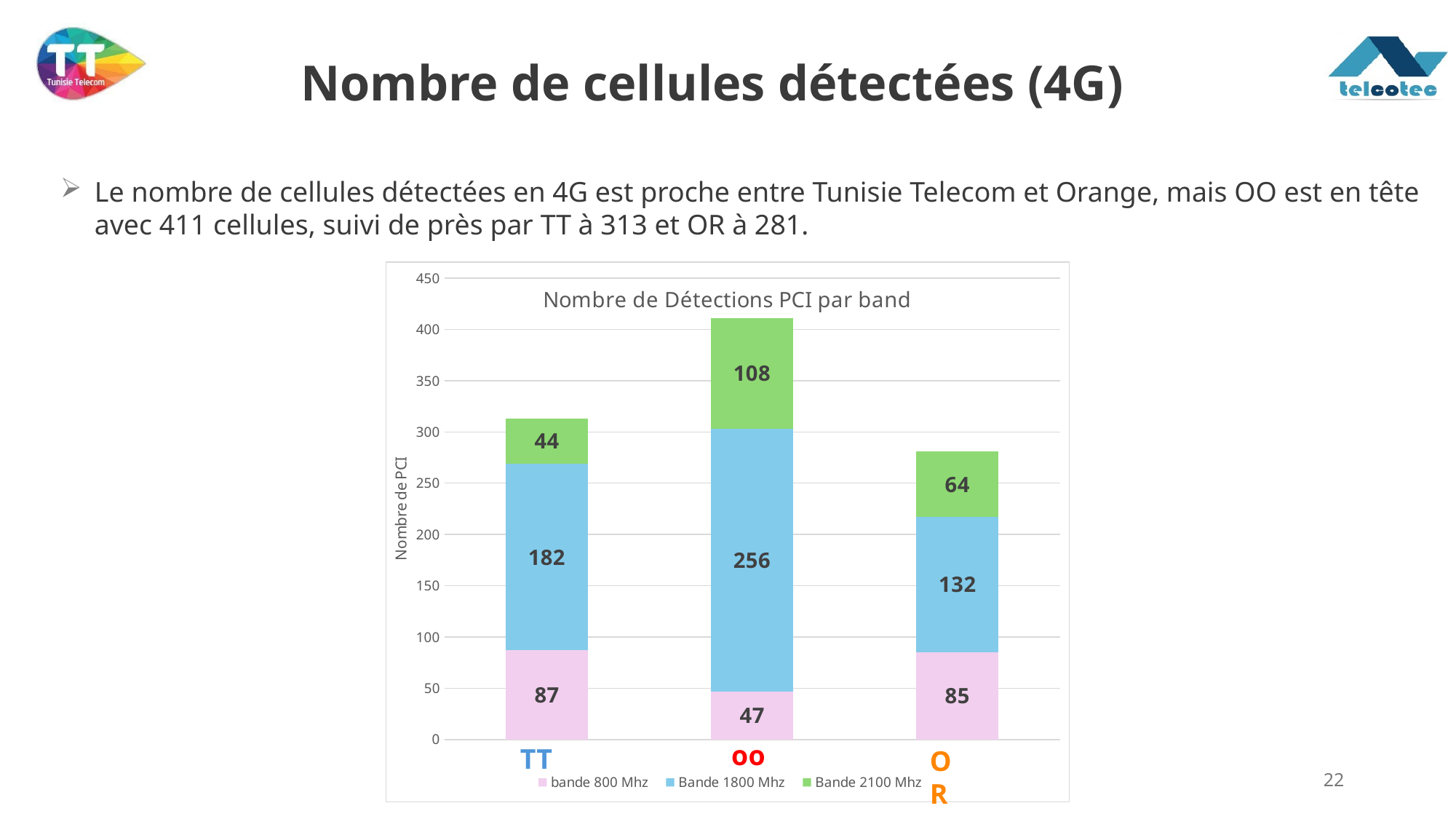
Is the total stacked bar for OO greater or less than 400? greater What is the total of the stacked bar for TT? 313 How many series does the legend list? 3 What kind of chart is shown on the slide? Stacked bar chart Which operator has the lowest bande 800 Mhz value? OO What is the value of Bande 2100 Mhz for OR? 64 What is the value of bande 800 Mhz for TT? 87 Which is larger: the Bande 2100 Mhz value for TT or for OR? OR Which operator has the highest Bande 2100 Mhz value? OO What is the value of Bande 1800 Mhz for OO? 256 How many operators (categories) are shown on the x axis? 3 What is the difference between the Bande 1800 Mhz values for OO and OR? 124